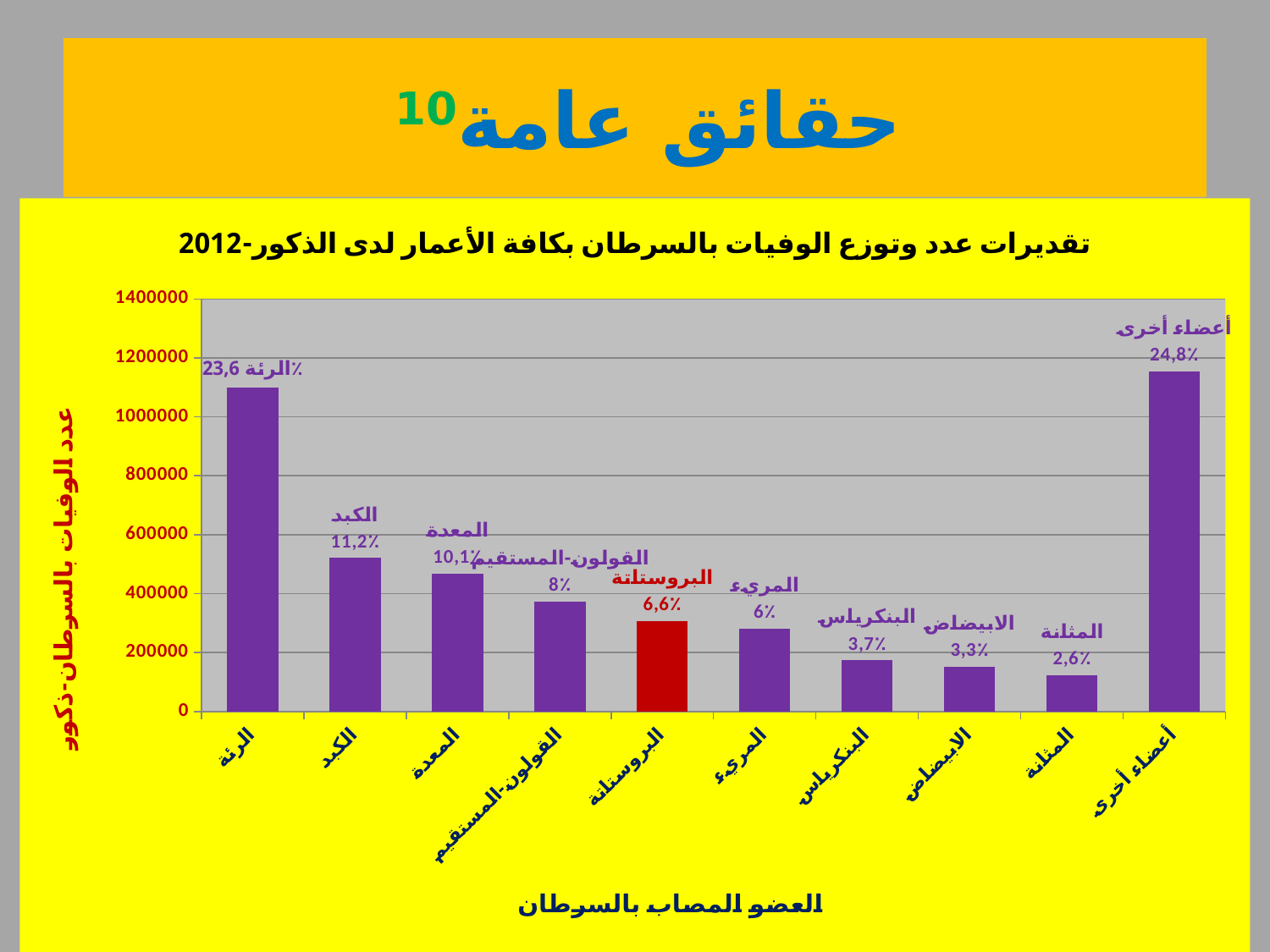
How many categories are shown on the x axis? 10 Is the value for الرئة greater or less than 1000000? greater What kind of chart is shown on the slide? bar chart Which has the larger percentage label, الكبد or المعدة? الكبد What percentage label is shown for البنكرياس (pancreas)? 3,7% What is the difference in percentage points between the labels for الرئة and الكبد? 12,4% What percentage label is shown for البروستاتة (prostate)? 6,6% Is the value for المثانة greater or less than 200000? less Which category has the tallest bar? أعضاء أخرى Which category has the shortest bar? المثانة What percentage label is shown for الرئة (lung)? 23,6% Which category's bar is coloured red instead of purple? البروستاتة